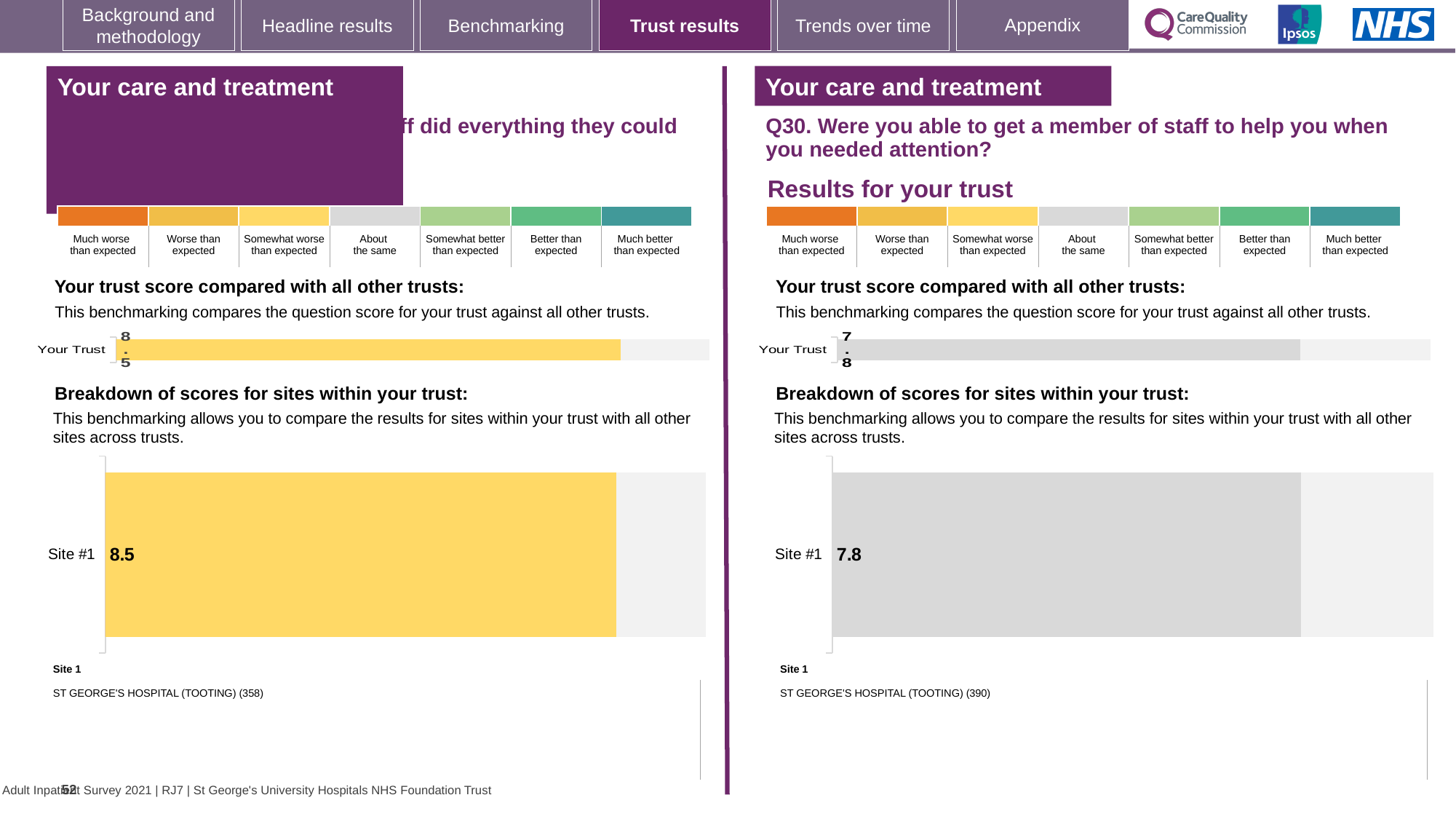
According to the colour key, which benchmarking category does the yellow Your Trust bar on the left half of the slide correspond to? Somewhat worse than expected In the 'Breakdown of scores for sites within your trust' chart on the right half of the slide (Q30), what is the score for Site #1? 7.8 Which site is listed as Site 1 on the left half of the slide? ST GEORGE'S HOSPITAL (TOOTING) (358) What is the difference between the Site #1 score on the left half of the slide and the Site #1 score on the right half (Q30)? 0.7 What colour is the Your Trust bar in the benchmarking chart on the right half of the slide (Q30)? Grey What type of chart is used to show the Site #1 score on the right half of the slide (Q30)? Bar chart How many sites are shown in the 'Breakdown of scores for sites within your trust' chart on the left half of the slide? 1 On the right half of the slide (Q30), what is the score shown for Your Trust in the 'Your trust score compared with all other trusts' chart? 7.8 In the 'Breakdown of scores for sites within your trust' chart on the left half of the slide, what is the score for Site #1? 8.5 On the left half of the slide, what is the score shown for Your Trust in the 'Your trust score compared with all other trusts' chart? 8.5 Which site is listed as Site 1 on the right half of the slide (Q30)? ST GEORGE'S HOSPITAL (TOOTING) (390) Which is larger: the Your Trust score on the left half of the slide or the Your Trust score on the right half (Q30)? Left half (8.5)